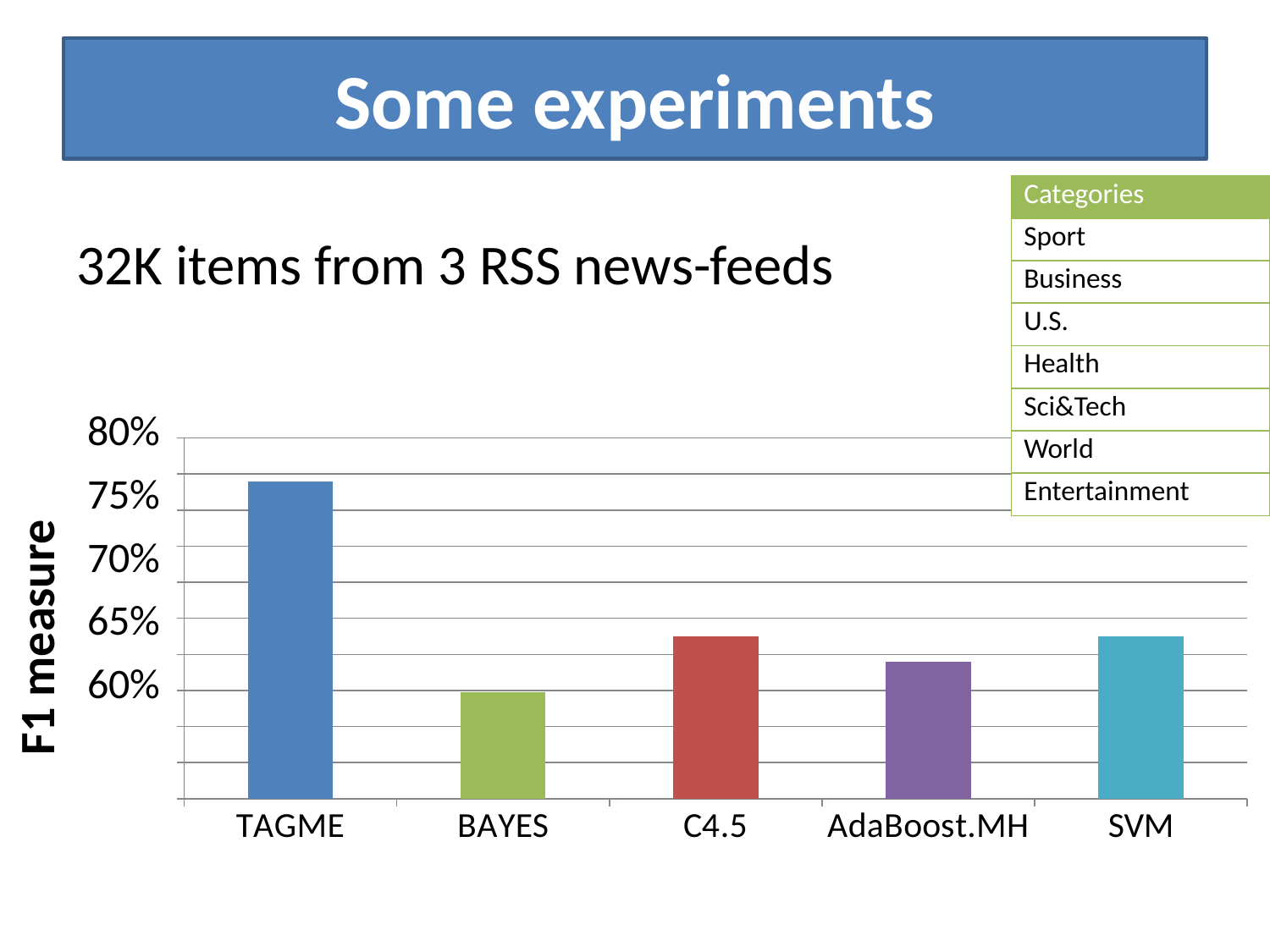
Which method's bar is coloured blue in the chart? TAGME How many methods (bars) are plotted in the chart? 5 Which method has the lowest F1 measure in the chart? BAYES Which has a higher F1 measure, C4.5 or AdaBoost.MH? C4.5 What is the label of the vertical axis of the chart? F1 measure Is the F1 measure for SVM greater or less than 70%? less Is the F1 measure for C4.5 greater or less than 65%? less What kind of chart is shown on the slide? bar chart Which has a higher F1 measure, TAGME or BAYES? TAGME Is the F1 measure for AdaBoost.MH greater or less than 60%? greater Which method has the highest F1 measure in the chart? TAGME